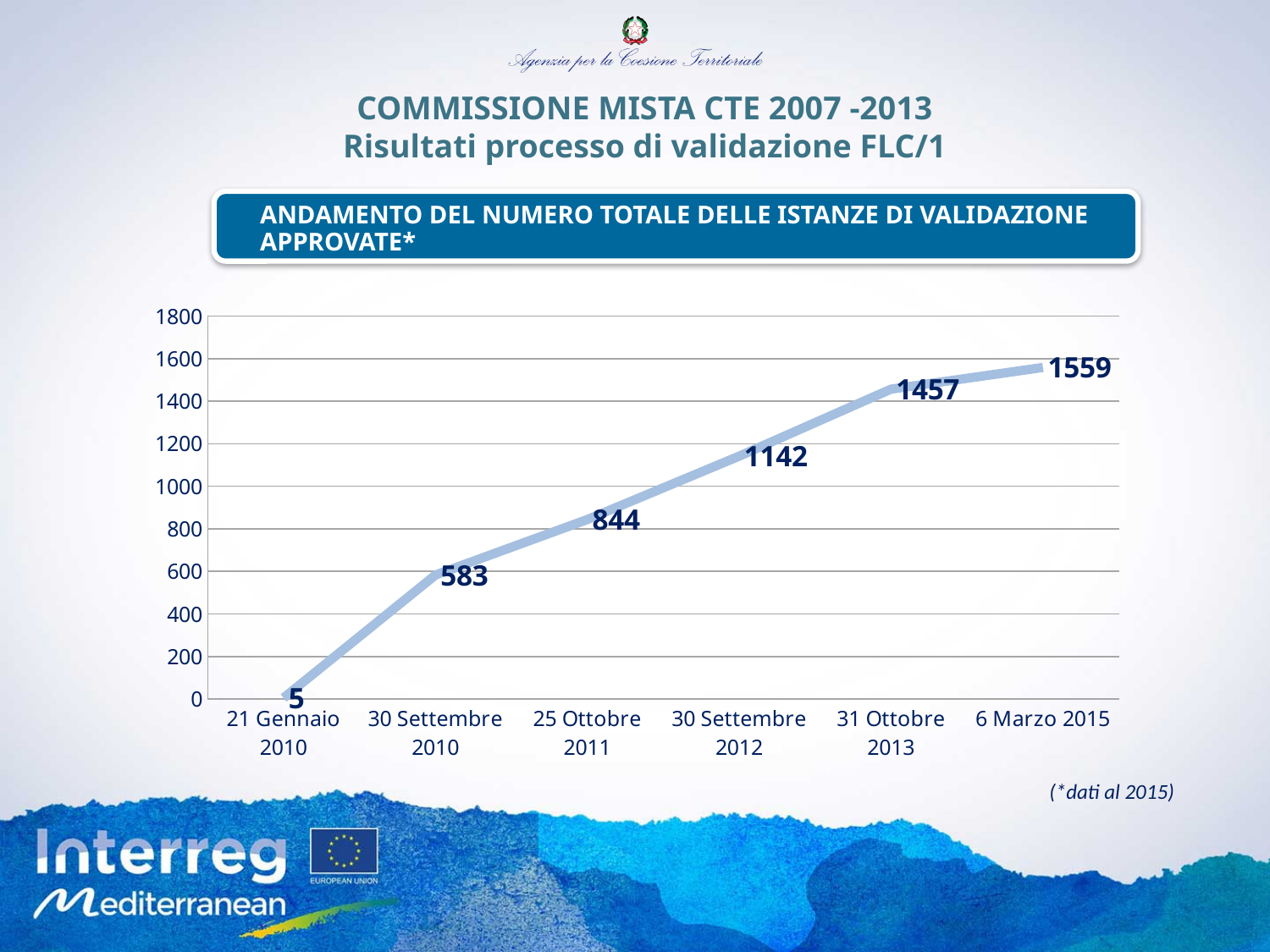
What is the difference between the values for 31 Ottobre 2013 and 30 Settembre 2012? 315 What kind of chart is shown on the slide? Line chart What is the value for 21 Gennaio 2010? 5 What is the value for 25 Ottobre 2011? 844 What is the value for 6 Marzo 2015? 1559 Which date has the highest value? 6 Marzo 2015 What is the value for 30 Settembre 2010? 583 Do the values rise or fall from 21 Gennaio 2010 to 6 Marzo 2015? Rise Which date has the lowest value? 21 Gennaio 2010 How many data points are plotted on the chart? 6 What is the difference between the values for 6 Marzo 2015 and 31 Ottobre 2013? 102 Which is larger, the value for 25 Ottobre 2011 or the value for 30 Settembre 2012? 30 Settembre 2012